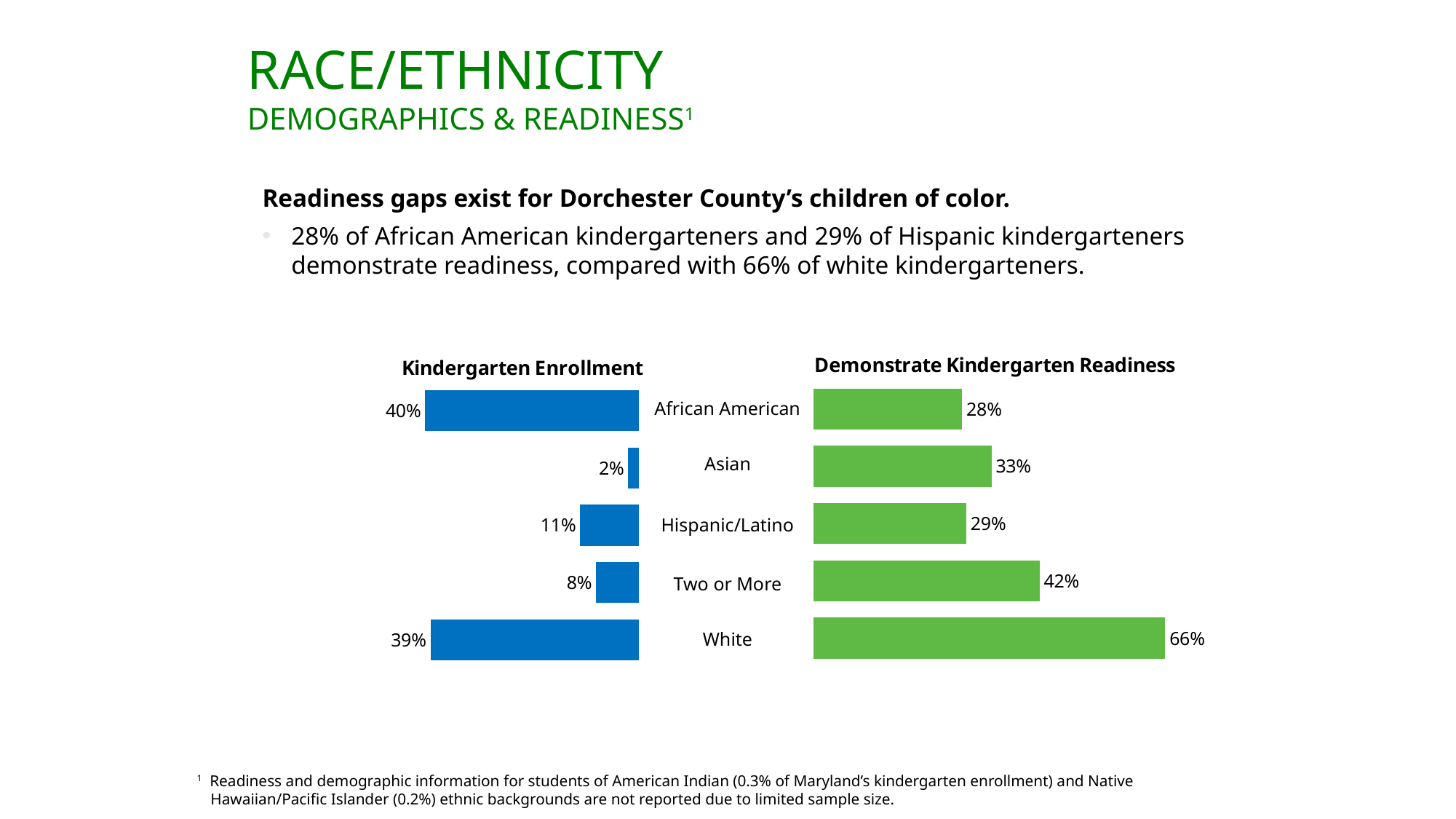
In the Kindergarten Enrollment chart, which category has the lowest value? Asian In the Demonstrate Kindergarten Readiness chart, what is the difference between White and African American? 38% What colour are the bars in the Demonstrate Kindergarten Readiness chart? Green In the Demonstrate Kindergarten Readiness chart, what is the value for Two or More? 42% How many categories are shown in the Demonstrate Kindergarten Readiness chart? 5 In the Kindergarten Enrollment chart, what is the value for African American? 40% In the Demonstrate Kindergarten Readiness chart, what is the value for Asian? 33% In the Kindergarten Enrollment chart, which is larger, the value for Hispanic/Latino or the value for Two or More? Hispanic/Latino In the Demonstrate Kindergarten Readiness chart, which category has the highest value? White What kind of chart is the Kindergarten Enrollment chart? Bar chart In the Demonstrate Kindergarten Readiness chart, which category has the lowest value? African American In the Kindergarten Enrollment chart, what is the difference between Hispanic/Latino and Two or More? 3%